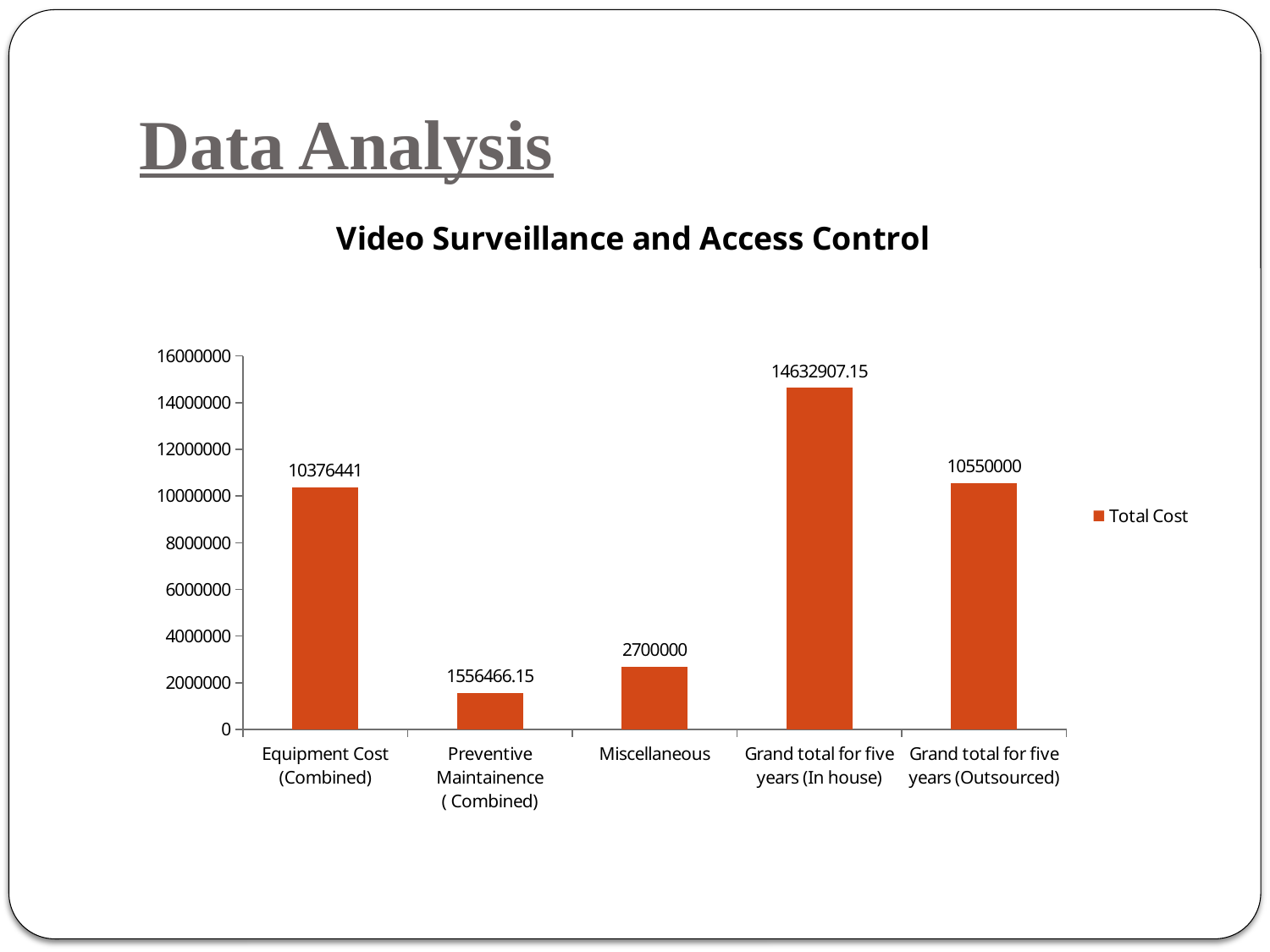
What is the Total Cost for Equipment Cost (Combined)? 10376441 How many categories are shown on the x axis of the chart? 5 Which category has the highest Total Cost? Grand total for five years (In house) Which is larger, the Total Cost for Grand total for five years (Outsourced) or for Equipment Cost (Combined)? Grand total for five years (Outsourced) What is the difference in Total Cost between Grand total for five years (In house) and Grand total for five years (Outsourced)? 4082907.15 Which category has the lowest Total Cost? Preventive Maintainence (Combined) What is the Total Cost for Grand total for five years (Outsourced)? 10550000 What is the Total Cost for Miscellaneous? 2700000 What is the Total Cost for Grand total for five years (In house)? 14632907.15 What type of chart is shown on the slide? Bar chart What is the title of the chart? Video Surveillance and Access Control What is the Total Cost for Preventive Maintainence (Combined)? 1556466.15